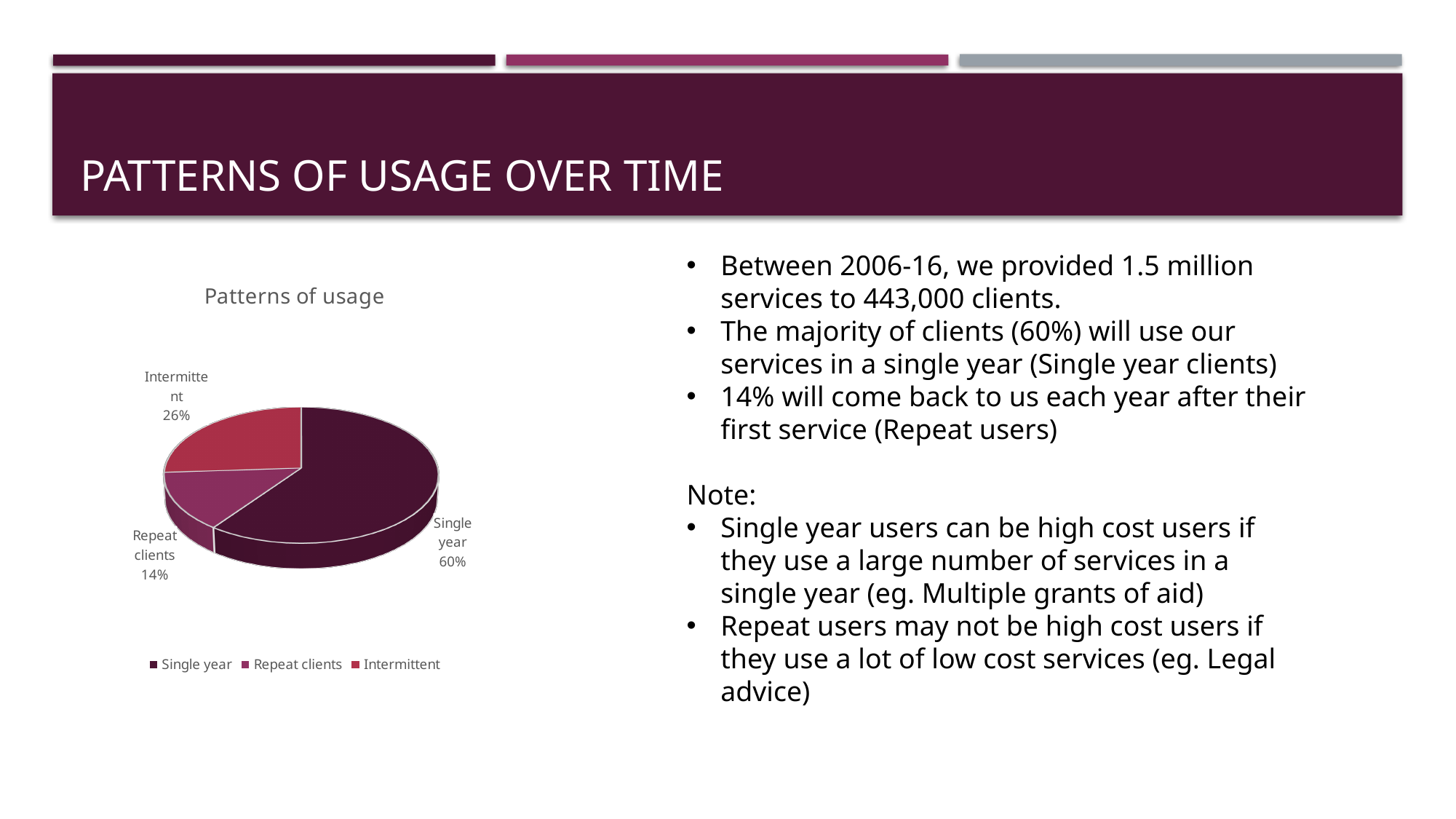
What is the title of the chart? Patterns of usage What is the difference in percentage points between Intermittent and Repeat clients? 12 What share of the pie does Intermittent represent? 26% How many categories are shown in the pie chart? 3 Which category has the smallest slice of the pie? Repeat clients What kind of chart is shown on the slide? Pie chart What share of the pie does Repeat clients represent? 14% How many entries does the chart legend list? 3 Which category has the largest slice of the pie? Single year What share of the pie does Single year represent? 60% Which is larger, the Intermittent slice or the Repeat clients slice? Intermittent What is the difference in percentage points between Single year and Intermittent? 34